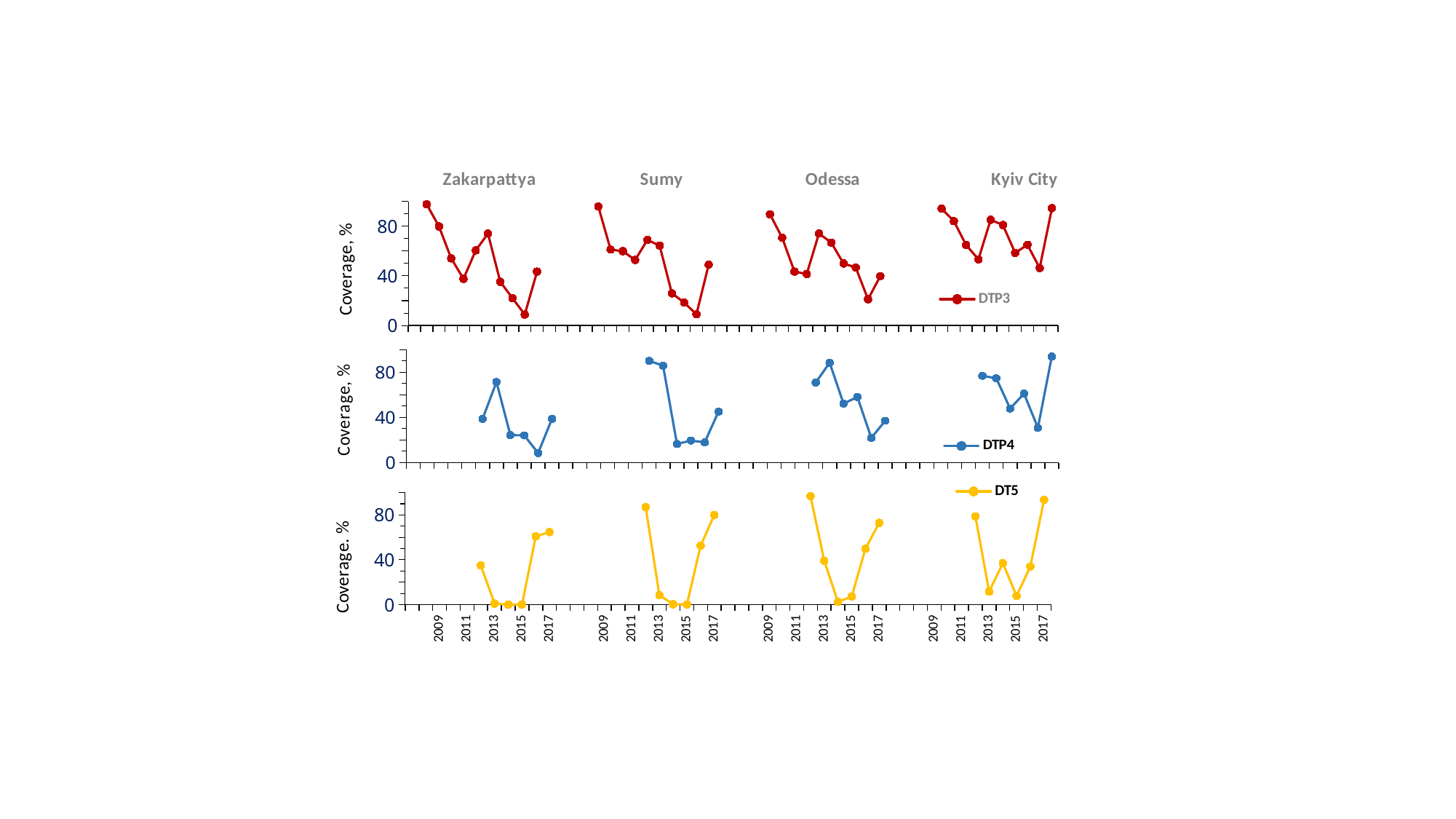
In the DTP3 (top) chart, is the value for Sumy in 2015 greater or less than 40? less In the DTP3 (top) chart, is the value for Odessa in 2016 greater or less than 40? less What kind of chart is used in each of the three panels on the slide? line chart In the DT5 (bottom) chart, do the values for Sumy rise or fall from 2015 to 2017? rise In the DTP4 (middle) chart, is the value for Sumy in 2012 greater or less than 80? greater Which three series are named in the legends of the three panels? DTP3, DTP4, DT5 Which four regions are labelled across the top of the charts? Zakarpattya, Sumy, Odessa, Kyiv City How many regions are plotted in each panel? 4